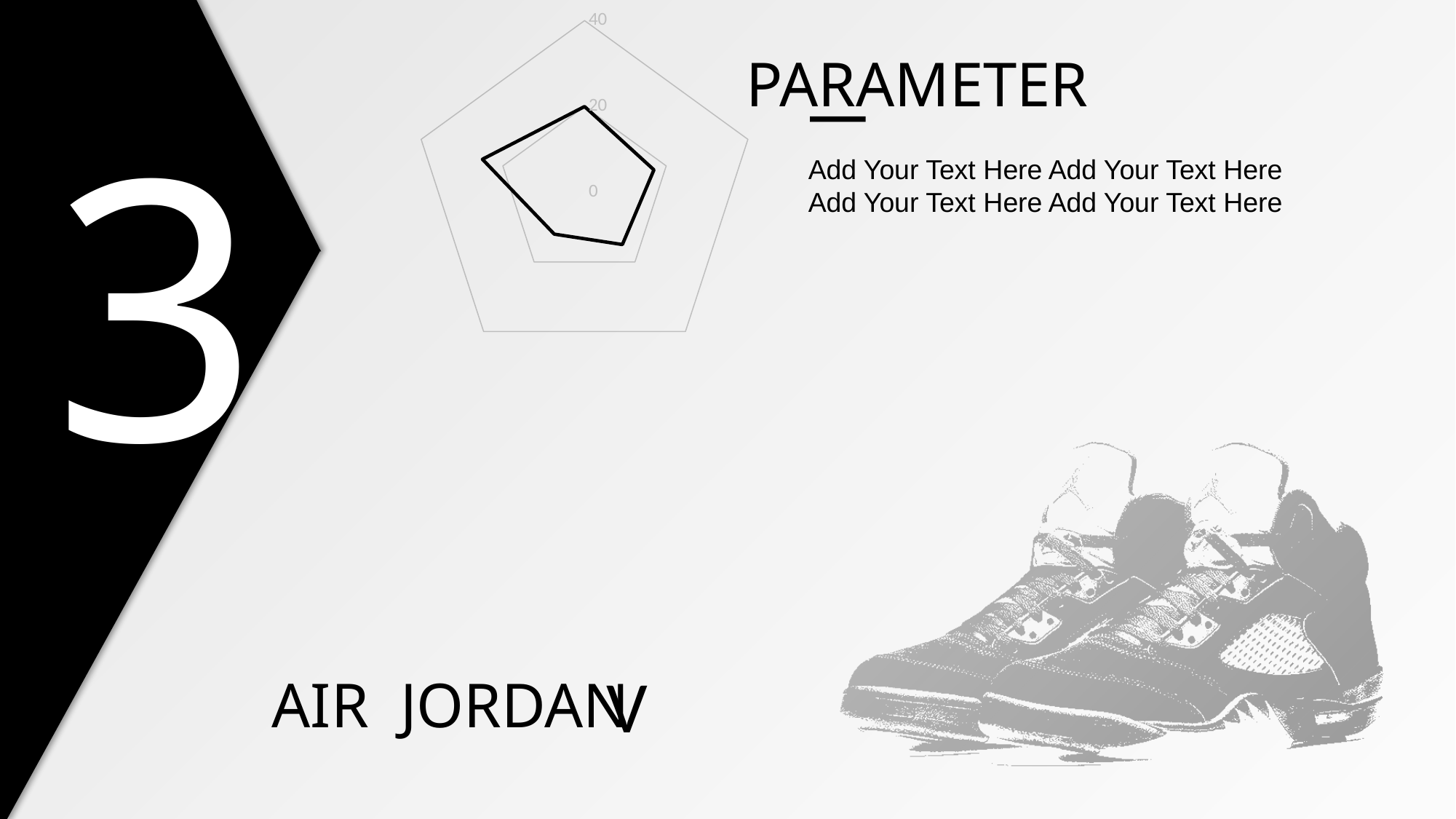
Is the value at the top axis of the radar chart greater or less than 40? less How many axes (data points) does the radar chart have? 5 Is the value at the bottom-left axis of the radar chart greater or less than 20? less What is the highest value marked on the radar chart's axis? 40 What tick values are labelled on the radar chart's axis? 0, 20, 40 How many data series are plotted on the radar chart? 1 What kind of chart is shown on the slide? radar chart